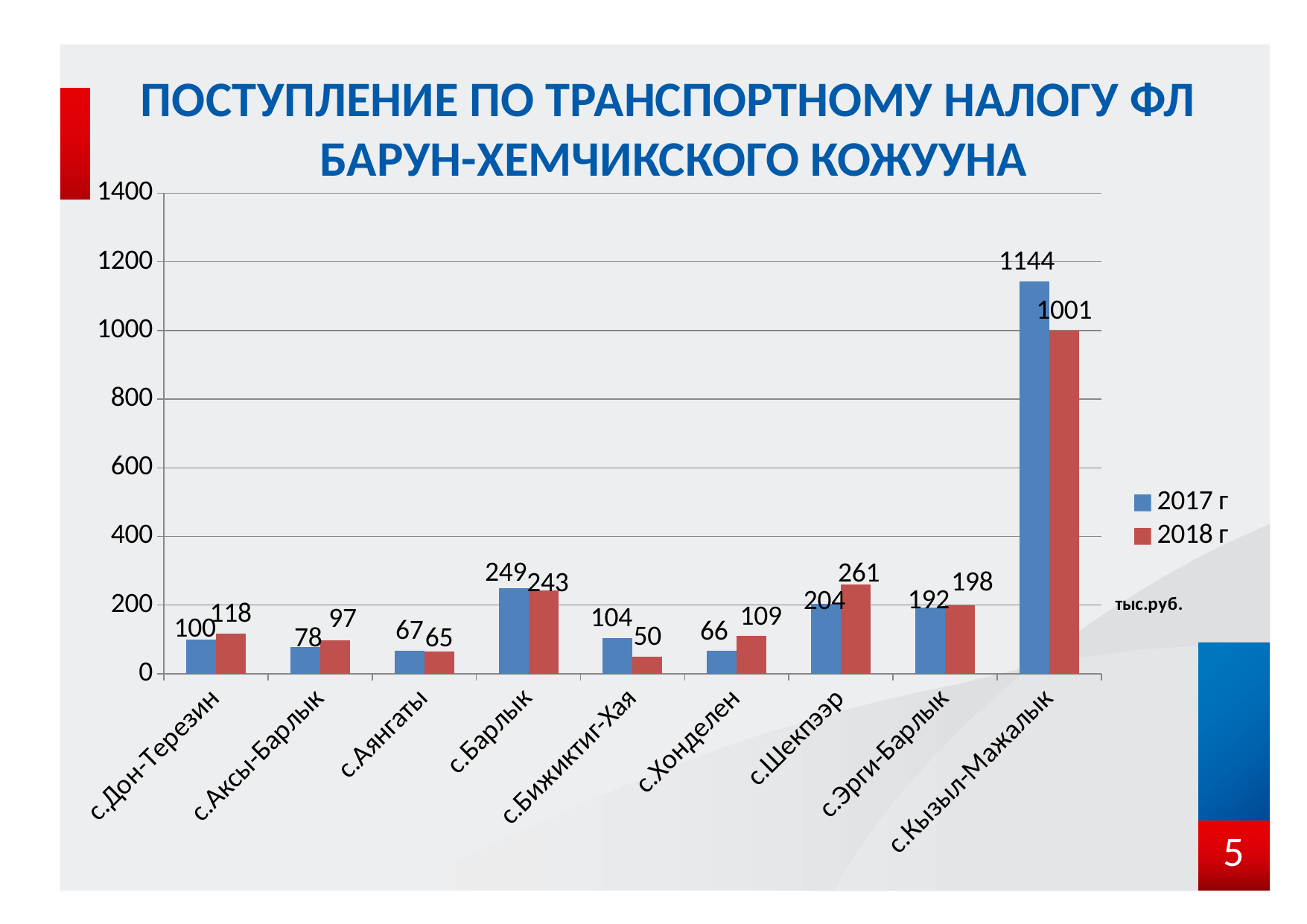
What is the 2017 г value for с.Кызыл-Мажалык? 1144 What is the difference between the 2017 г and 2018 г values for с.Кызыл-Мажалык? 143 Which category has the lowest 2017 г value? с.Хонделен What is the difference between the 2018 г and 2017 г values for с.Хонделен? 43 Which category has the highest 2018 г value? с.Кызыл-Мажалык Which is larger for с.Бижиктиг-Хая, the 2017 г value or the 2018 г value? 2017 г What kind of chart is shown on the slide? bar chart How many series does the legend list? 2 What is the 2018 г value for с.Шекпээр? 261 Is the 2018 г value for с.Кызыл-Мажалык greater or less than 1200? less How many categories are shown on the x axis? 9 What is the 2018 г value for с.Бижиктиг-Хая? 50